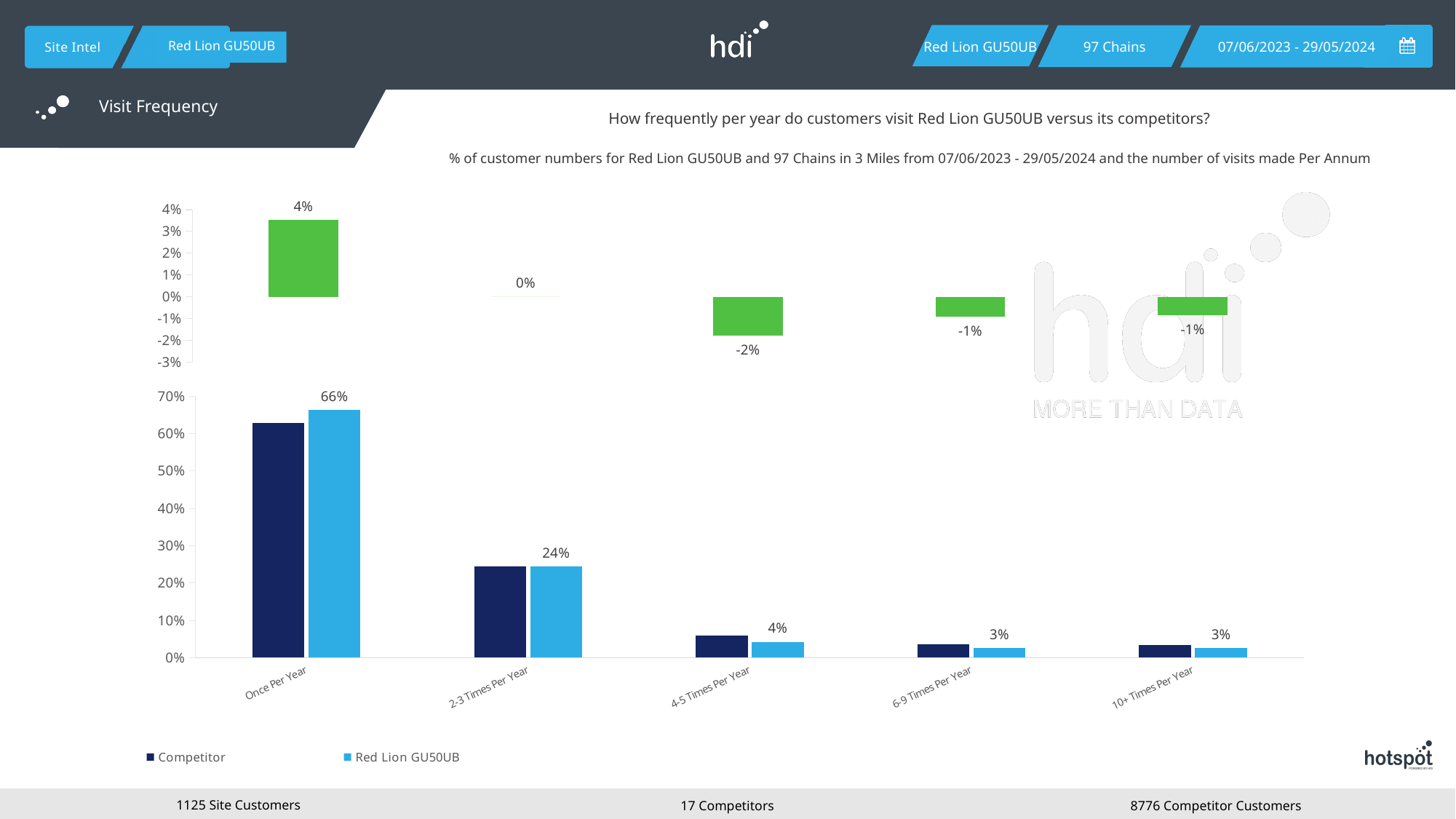
In the bottom bar chart, what is the difference between the Red Lion GU50UB values for Once Per Year and 2-3 Times Per Year? 42% In the top chart, what is the value shown for Once Per Year? 4% In the bottom bar chart, is the Competitor value for 4-5 Times Per Year greater or less than 10%? less In the bottom bar chart, is the Competitor value for Once Per Year greater or less than 50%? greater In the bottom bar chart, what is the value for Red Lion GU50UB for 2-3 Times Per Year? 24% In the bottom bar chart, how many categories are shown on the x axis? 5 In the bottom bar chart, what is the value for Red Lion GU50UB for 4-5 Times Per Year? 4% In the top chart, what is the value shown for 4-5 Times Per Year? -2% In the bottom bar chart, what is the value for Red Lion GU50UB for Once Per Year? 66% In the bottom bar chart, how many series does the legend list? 2 In the bottom bar chart, which category has the highest value for Red Lion GU50UB? Once Per Year What kind of chart is the bottom chart? Bar chart